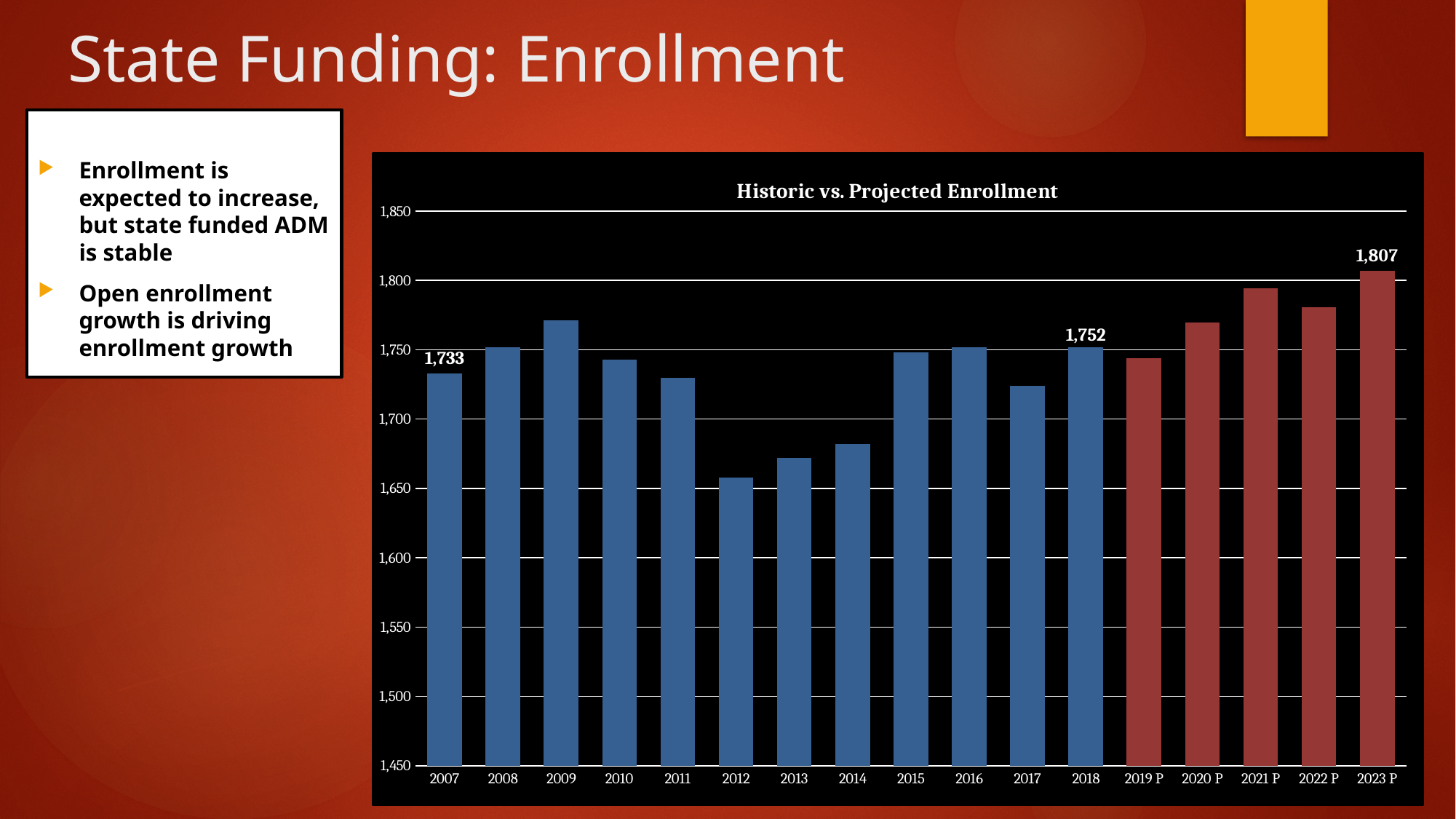
What is the title of the chart? Historic vs. Projected Enrollment Is the value for 2021 P greater or less than 1,800? less Which year has the highest bar in the chart? 2023 P Is the value for 2009 greater or less than 1,750? greater How many years (bars) are shown on the x axis? 17 Which year has the lowest bar in the chart? 2012 What is the enrollment value shown for 2018? 1,752 What is the difference between the 2018 value and the 2007 value? 19 How much higher is the 2023 P value than the 2007 value? 74 Is the value for 2012 greater or less than 1,700? less What is the projected enrollment value shown for 2023 P? 1,807 What is the enrollment value shown for 2007? 1,733